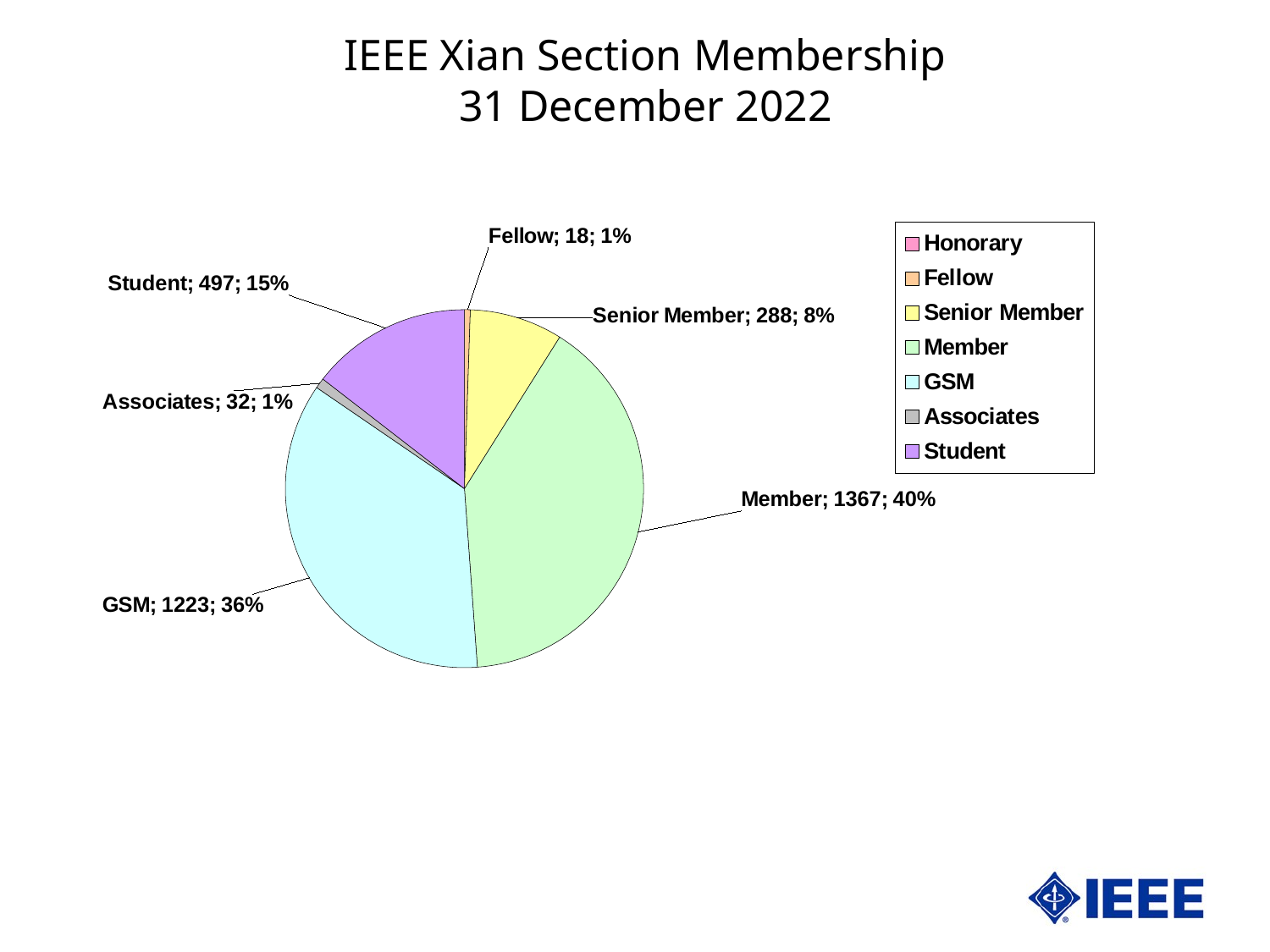
What share of the pie does the GSM slice represent? 36% Which category has the largest slice of the pie? Member What is the value shown for Fellow? 18 What type of chart is shown on the slide? pie chart What is the value shown for GSM? 1223 Which is larger, the value for Student or the value for Senior Member? Student What is the title of the chart? IEEE Xian Section Membership 31 December 2022 How many entries does the legend list? 7 What is the value shown for Senior Member? 288 What is the difference between the Member value and the GSM value? 144 What share of the pie does the Student slice represent? 15% How many members are in the Member category? 1367